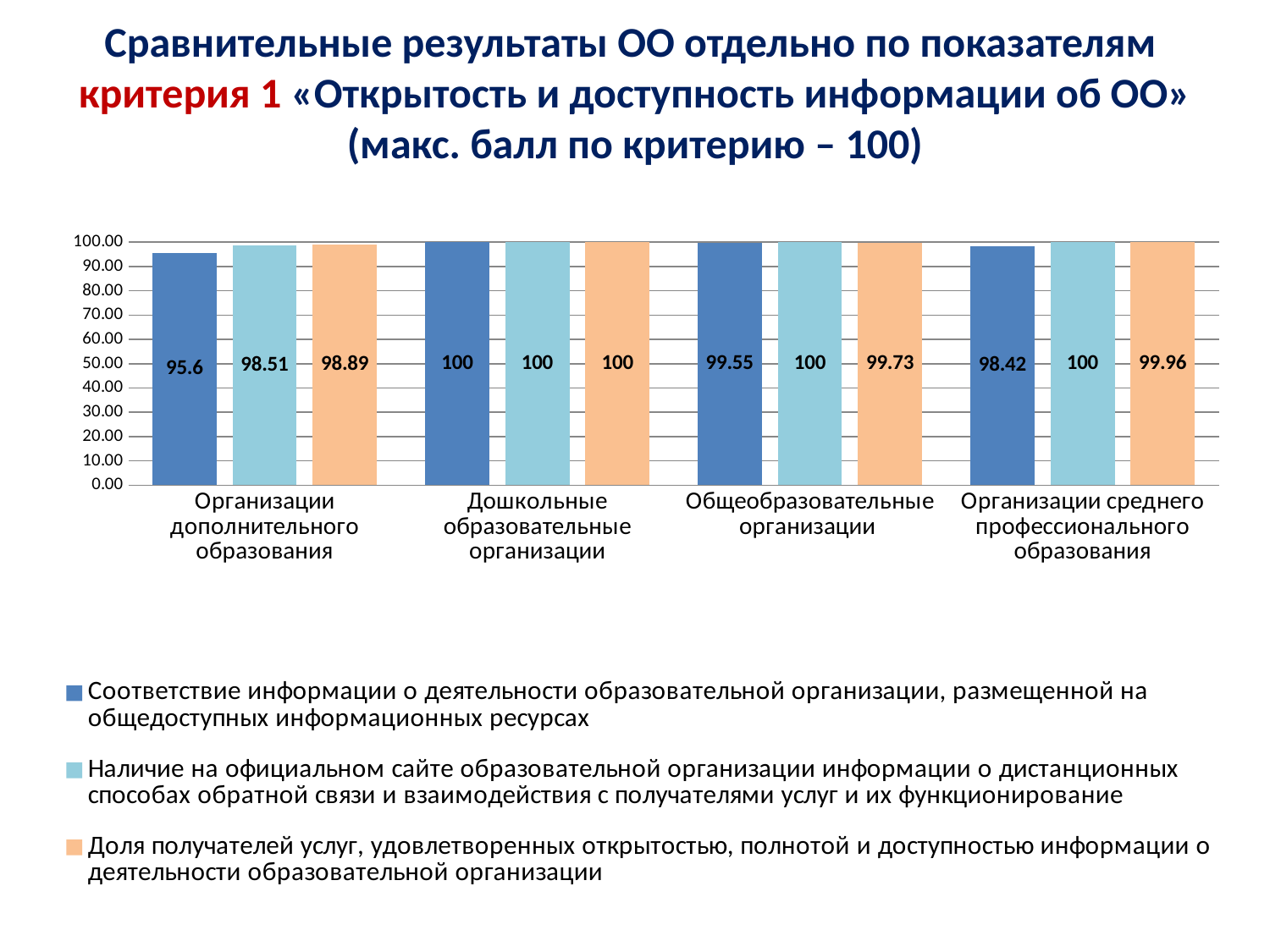
How many categories are shown on the x axis of the chart? 4 For Организации дополнительного образования, what is the difference between the value of the series «Доля получателей услуг...» (98.89) and the series «Соответствие информации...» (95.6)? 3.29 For Организации среднего профессионального образования, what is the difference between the series «Наличие на официальном сайте...» and the series «Соответствие информации...»? 1.58 Which category has the lowest value in the series «Соответствие информации о деятельности образовательной организации, размещенной на общедоступных информационных ресурсах»? Организации дополнительного образования What is the value for Организации среднего профессионального образования in the series «Соответствие информации о деятельности образовательной организации, размещенной на общедоступных информационных ресурсах»? 98.42 How many series does the legend list? 3 What colour represents the series «Доля получателей услуг, удовлетворенных открытостью, полнотой и доступностью информации о деятельности образовательной организации»? Orange What is the value for Организации дополнительного образования in the series «Соответствие информации о деятельности образовательной организации, размещенной на общедоступных информационных ресурсах»? 95.6 What is the value for Общеобразовательные организации in the series «Доля получателей услуг, удовлетворенных открытостью, полнотой и доступностью информации о деятельности образовательной организации»? 99.73 What kind of chart is shown on the slide? Bar chart What is the value for Дошкольные образовательные организации in the series «Наличие на официальном сайте образовательной организации информации о дистанционных способах обратной связи и взаимодействия с получателями услуг и их функционирование»? 100 In the series «Соответствие информации о деятельности образовательной организации...», which is larger: Общеобразовательные организации or Организации среднего профессионального образования? Общеобразовательные организации